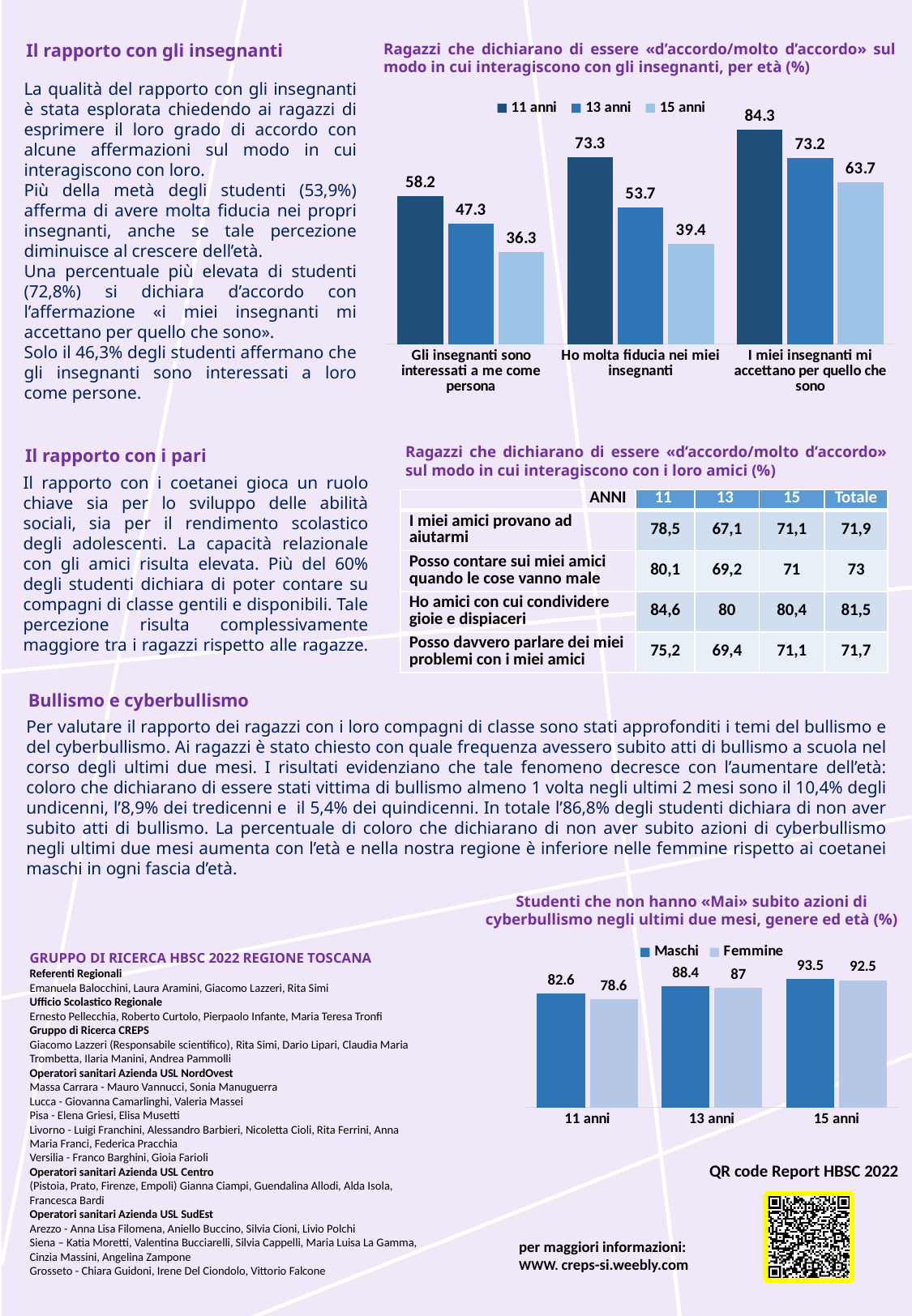
What kind of chart is the bottom-right chart about cyberbullying? Bar chart In the top-right chart about interactions with teachers, which category has the lowest value for 15 anni? Gli insegnanti sono interessati a me come persona In the bottom-right chart about cyberbullying, how many age groups are shown on the x axis? 3 In the top-right chart about interactions with teachers, how do the values change from 11 anni to 15 anni within each category? They fall In the bottom-right chart about cyberbullying, which is larger at 11 anni: Maschi or Femmine? Maschi In the top-right chart about interactions with teachers, which category has the highest value for 11 anni? I miei insegnanti mi accettano per quello che sono In the top-right chart about interactions with teachers, what is the value for 11 anni in the category 'Ho molta fiducia nei miei insegnanti'? 73.3 In the bottom-right chart about cyberbullying, what is the value for Femmine at 13 anni? 87 In the top-right chart about interactions with teachers, what is the value for 15 anni in the category 'Gli insegnanti sono interessati a me come persona'? 36.3 In the top-right chart about interactions with teachers, what is the difference between the 11 anni and 15 anni values for 'I miei insegnanti mi accettano per quello che sono'? 20.6 In the bottom-right chart about cyberbullying, what is the difference between Maschi and Femmine at 11 anni? 4 In the top-right chart about interactions with teachers, how many age series does the legend list? 3